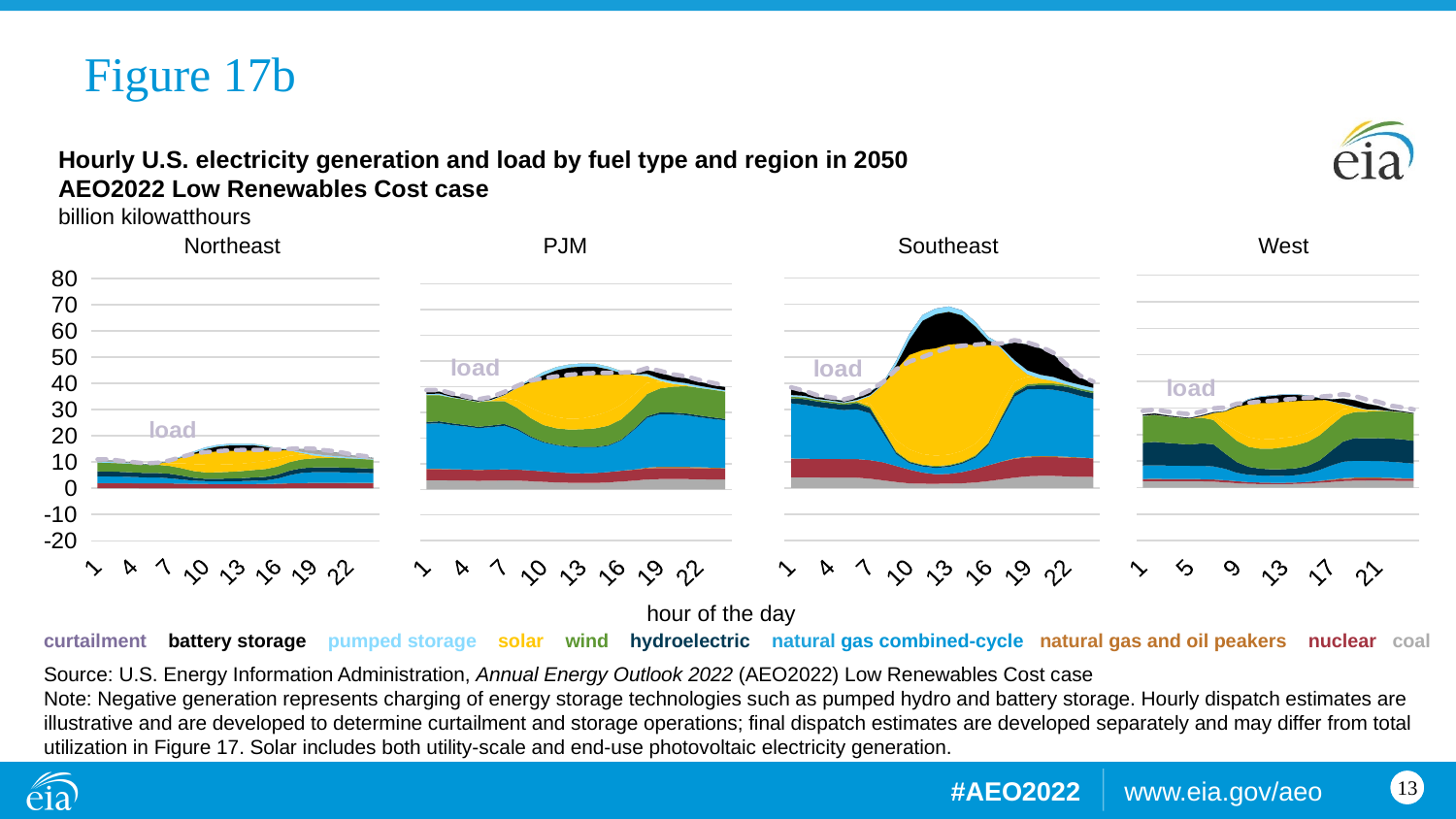
What is the label on the shared x axis of the charts? hour of the day In the West chart, is the peak load greater or less than 40 billion kilowatthours? less Which region's chart shows the highest peak load? Southeast What unit is given for the values plotted in the charts? billion kilowatthours What kind of chart is used for each of the four regional panels on this slide? stacked area chart How many fuel-type series does the legend list? 10 How many regional charts are shown on the slide? 4 In the Northeast chart, is the peak load greater or less than 20 billion kilowatthours? less Which region's chart shows the lowest peak load? Northeast In the Southeast chart, is the peak load greater or less than 50 billion kilowatthours? greater In the Southeast chart, does the load rise or fall between hour 1 and hour 13? rise Which region has a higher peak load, PJM or Northeast? PJM